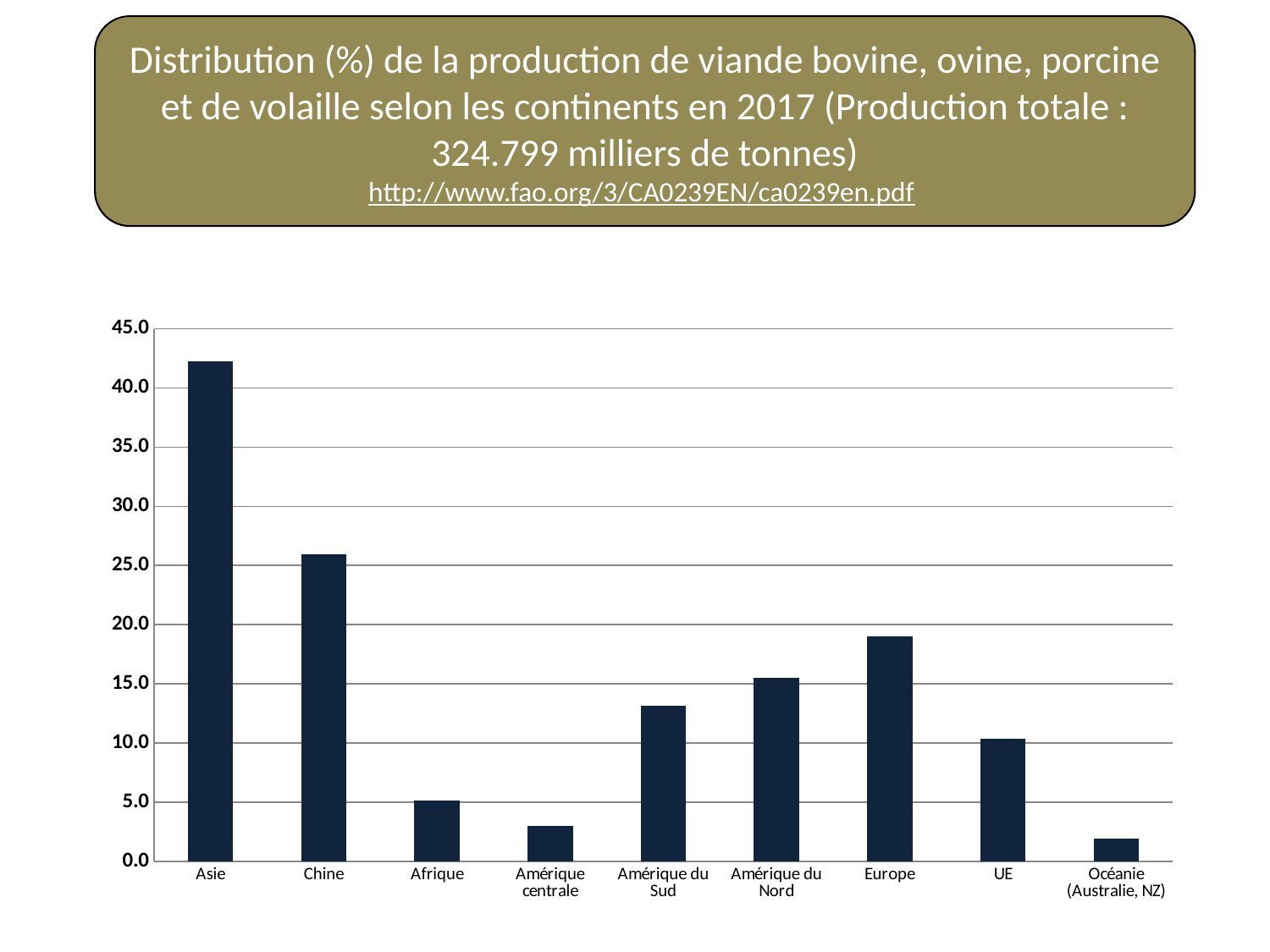
Is the value for Amérique centrale greater or less than 5.0? less What kind of chart is shown on the slide? bar chart Is the value for Océanie (Australie, NZ) greater or less than 5.0? less Which category has the lowest value in the chart? Océanie (Australie, NZ) Is the value for Europe greater or less than 20.0? less Which is larger, the value for Chine or the value for UE? Chine Which category has the highest value in the chart? Asie How many categories are shown on the x axis of the chart? 9 Which is larger, the value for Europe or the value for Amérique du Nord? Europe